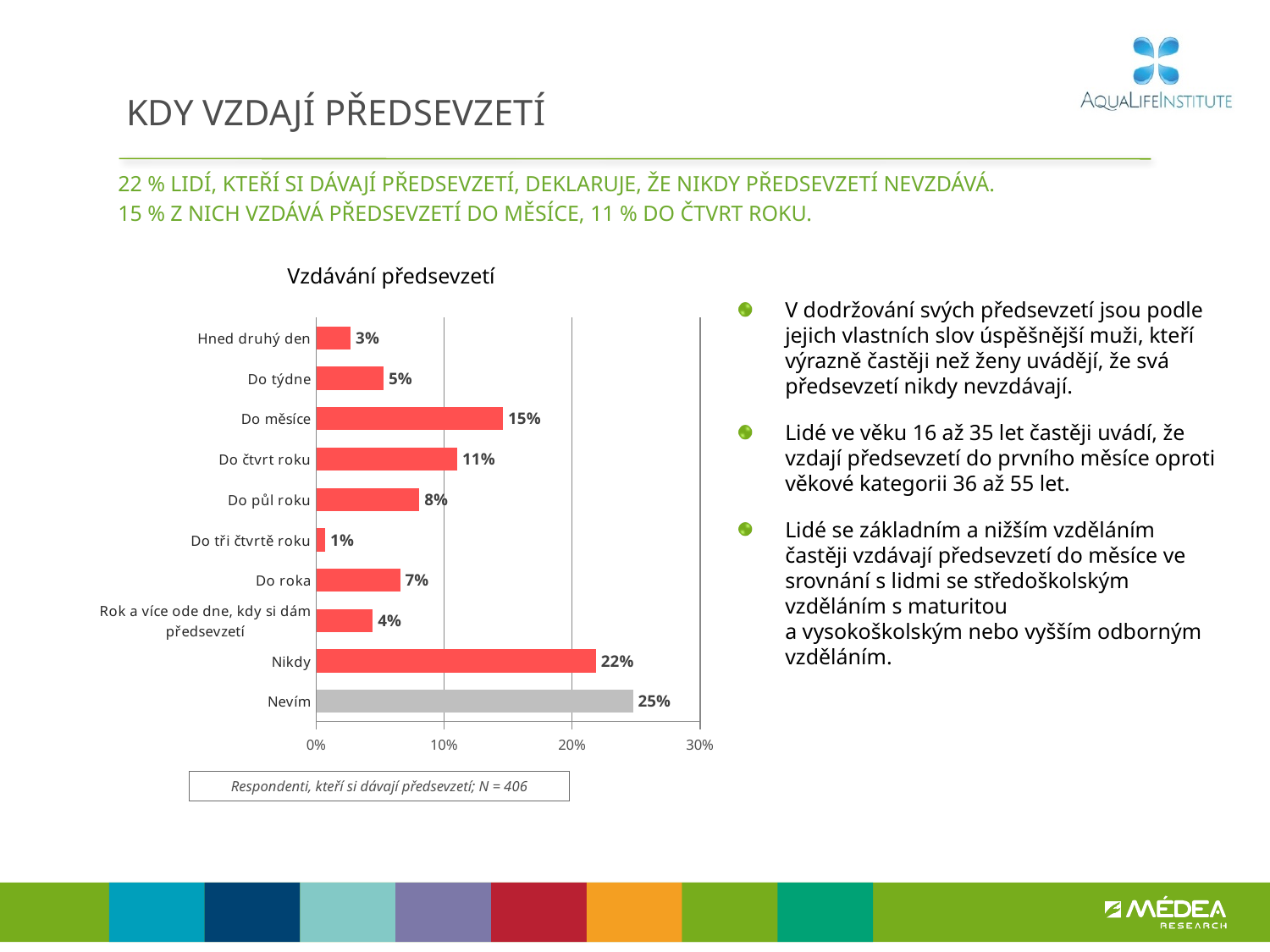
Is the value for "Nikdy" greater or less than 20%? greater How many categories are shown in the chart? 10 What kind of chart is shown on the slide? bar chart Which category has the lowest value in the chart? Do tři čtvrtě roku What is the value for "Do měsíce" in the chart? 15% What is the value for "Do tři čtvrtě roku" in the chart? 1% What is the difference between the values for "Nevím" and "Nikdy"? 3% What is the value for "Nikdy" in the chart? 22% What is the value for "Rok a více ode dne, kdy si dám předsevzetí" in the chart? 4% Which is larger, the value for "Do čtvrt roku" or the value for "Do půl roku"? Do čtvrt roku What is the title of the chart? Vzdávání předsevzetí Which category has the highest value in the chart? Nevím